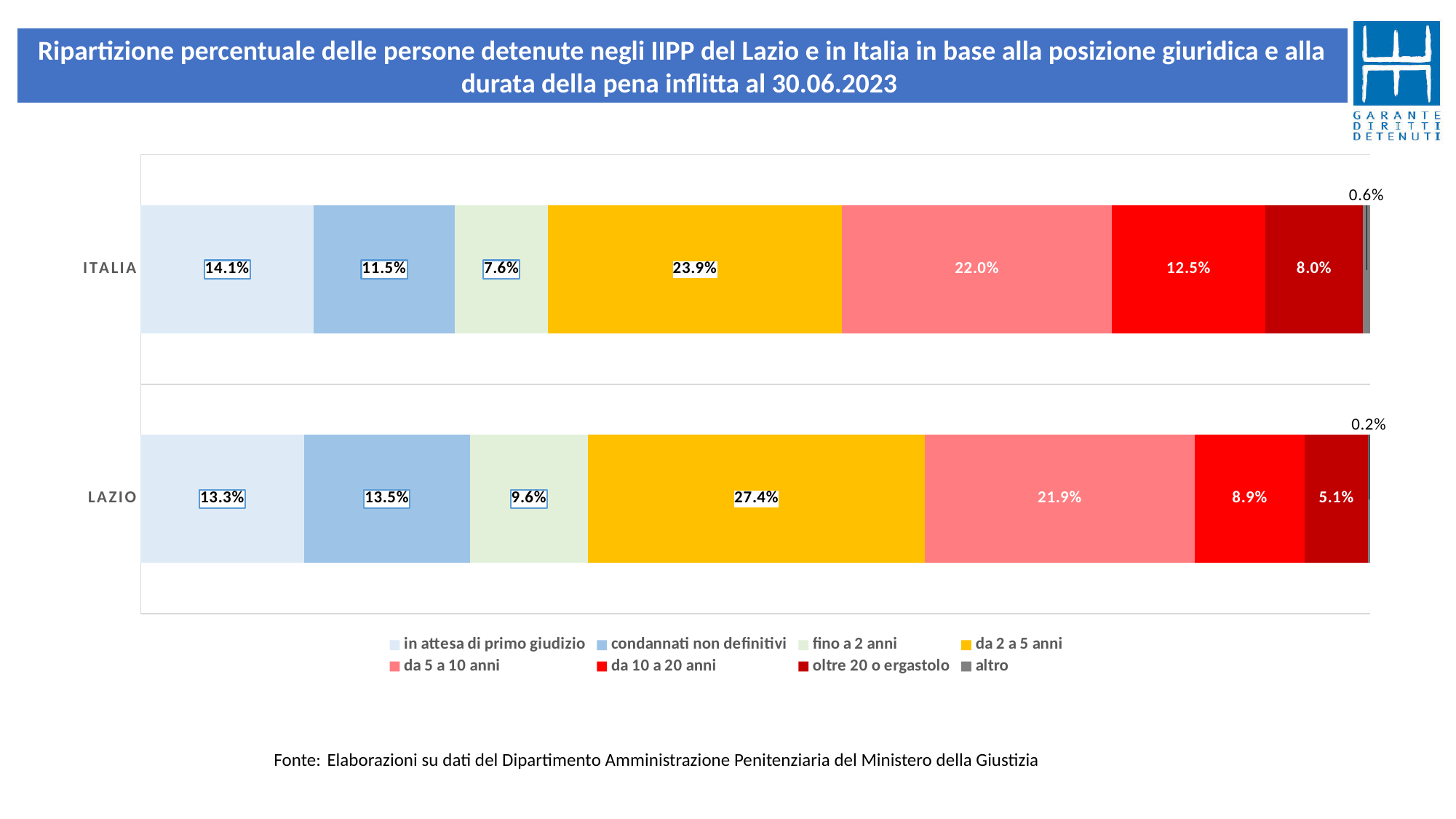
Which series has the highest value in the ITALIA bar? da 2 a 5 anni How many categories (bars) are shown on the chart? 2 What is the value for 'altro' for ITALIA? 0.6% What is the value for 'da 2 a 5 anni' for LAZIO? 27.4% Which is larger, the 'fino a 2 anni' value for ITALIA or for LAZIO? LAZIO What is the value for 'oltre 20 o ergastolo' for LAZIO? 5.1% What kind of chart is shown on the slide? stacked bar chart Which series has the lowest value in the LAZIO bar? altro What is the value for 'in attesa di primo giudizio' for ITALIA? 14.1% How many series does the legend list? 8 What is the difference between the 'da 10 a 20 anni' values for ITALIA and LAZIO? 3.6% What colour represents the 'da 2 a 5 anni' series? yellow